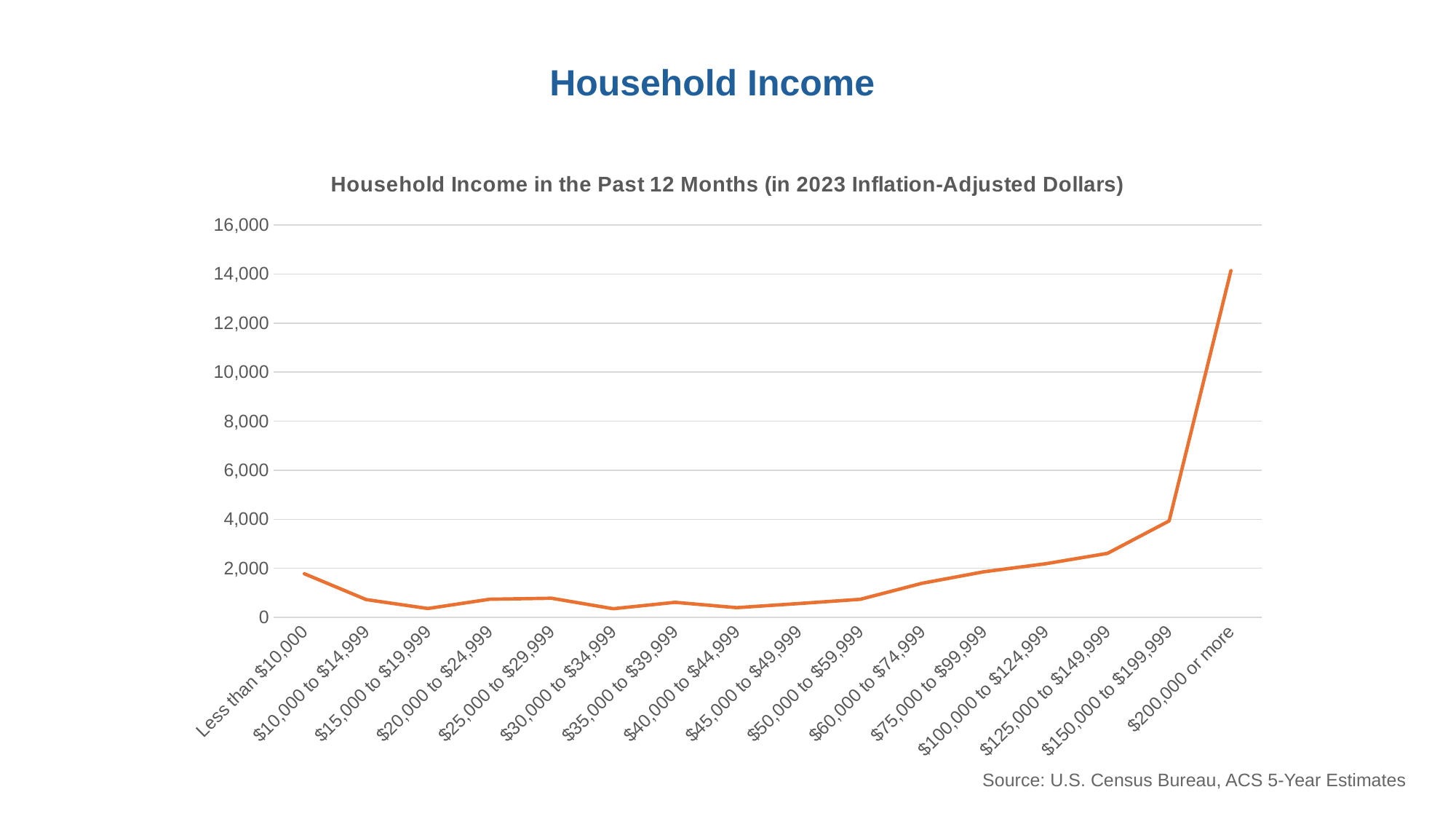
Do the values rise or fall from $50,000 to $59,999 through $200,000 or more? Rise How many income categories are plotted along the x axis? 16 What is the title of the chart? Household Income in the Past 12 Months (in 2023 Inflation-Adjusted Dollars) Is the value for $200,000 or more greater or less than 12,000? greater Which has a larger value: $200,000 or more or $150,000 to $199,999? $200,000 or more Which income category has the highest number of households? $200,000 or more Is the value for $125,000 to $149,999 greater or less than 2,000? greater Which has a larger value: Less than $10,000 or $15,000 to $19,999? Less than $10,000 What kind of chart is shown on the slide? Line chart What source is cited for the chart data? U.S. Census Bureau, ACS 5-Year Estimates Is the value for $150,000 to $199,999 greater or less than 6,000? less